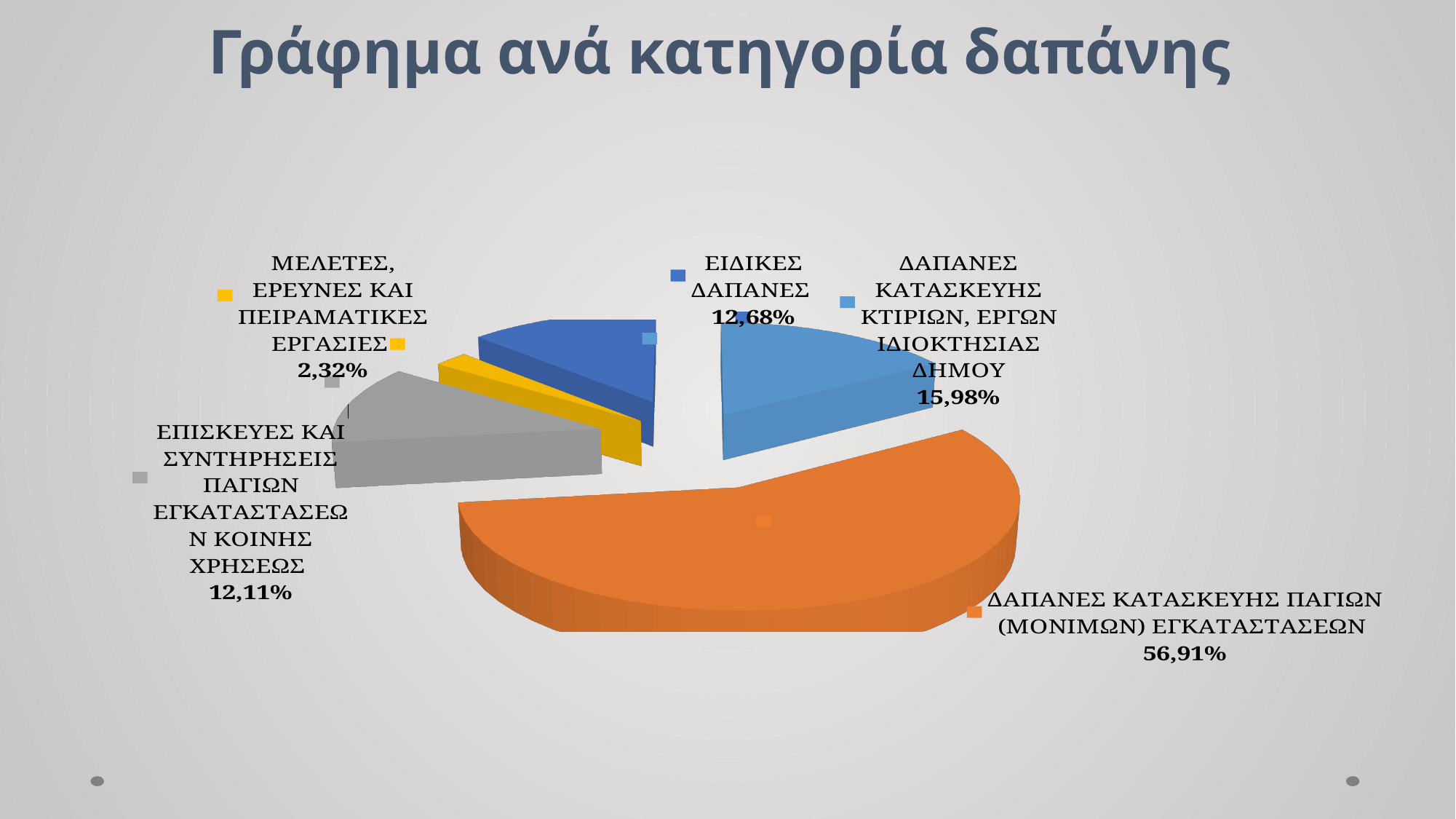
Which has the larger share: ΕΙΔΙΚΕΣ ΔΑΠΑΝΕΣ or ΕΠΙΣΚΕΥΕΣ ΚΑΙ ΣΥΝΤΗΡΗΣΕΙΣ ΠΑΓΙΩΝ ΕΓΚΑΤΑΣΤΑΣΕΩΝ ΚΟΙΝΗΣ ΧΡΗΣΕΩΣ? ΕΙΔΙΚΕΣ ΔΑΠΑΝΕΣ What is the difference in percentage points between ΔΑΠΑΝΕΣ ΚΑΤΑΣΚΕΥΗΣ ΠΑΓΙΩΝ (ΜΟΝΙΜΩΝ) ΕΓΚΑΤΑΣΤΑΣΕΩΝ and ΔΑΠΑΝΕΣ ΚΑΤΑΣΚΕΥΗΣ ΚΤΙΡΙΩΝ, ΕΡΓΩΝ ΙΔΙΟΚΤΗΣΙΑΣ ΔΗΜΟΥ? 40,93% What is the title of the chart? Γράφημα ανά κατηγορία δαπάνης What percentage is shown for ΕΠΙΣΚΕΥΕΣ ΚΑΙ ΣΥΝΤΗΡΗΣΕΙΣ ΠΑΓΙΩΝ ΕΓΚΑΤΑΣΤΑΣΕΩΝ ΚΟΙΝΗΣ ΧΡΗΣΕΩΣ? 12,11% Which category has the smallest share of the pie? ΜΕΛΕΤΕΣ, ΕΡΕΥΝΕΣ ΚΑΙ ΠΕΙΡΑΜΑΤΙΚΕΣ ΕΡΓΑΣΙΕΣ What share of the pie is ΔΑΠΑΝΕΣ ΚΑΤΑΣΚΕΥΗΣ ΠΑΓΙΩΝ (ΜΟΝΙΜΩΝ) ΕΓΚΑΤΑΣΤΑΣΕΩΝ? 56,91% What percentage is shown for ΔΑΠΑΝΕΣ ΚΑΤΑΣΚΕΥΗΣ ΚΤΙΡΙΩΝ, ΕΡΓΩΝ ΙΔΙΟΚΤΗΣΙΑΣ ΔΗΜΟΥ? 15,98% What kind of chart is shown on the slide? Pie chart How many slices does the pie chart have? 5 Which category has the largest share of the pie? ΔΑΠΑΝΕΣ ΚΑΤΑΣΚΕΥΗΣ ΠΑΓΙΩΝ (ΜΟΝΙΜΩΝ) ΕΓΚΑΤΑΣΤΑΣΕΩΝ What percentage is shown for ΜΕΛΕΤΕΣ, ΕΡΕΥΝΕΣ ΚΑΙ ΠΕΙΡΑΜΑΤΙΚΕΣ ΕΡΓΑΣΙΕΣ? 2,32% What percentage is shown for ΕΙΔΙΚΕΣ ΔΑΠΑΝΕΣ? 12,68%